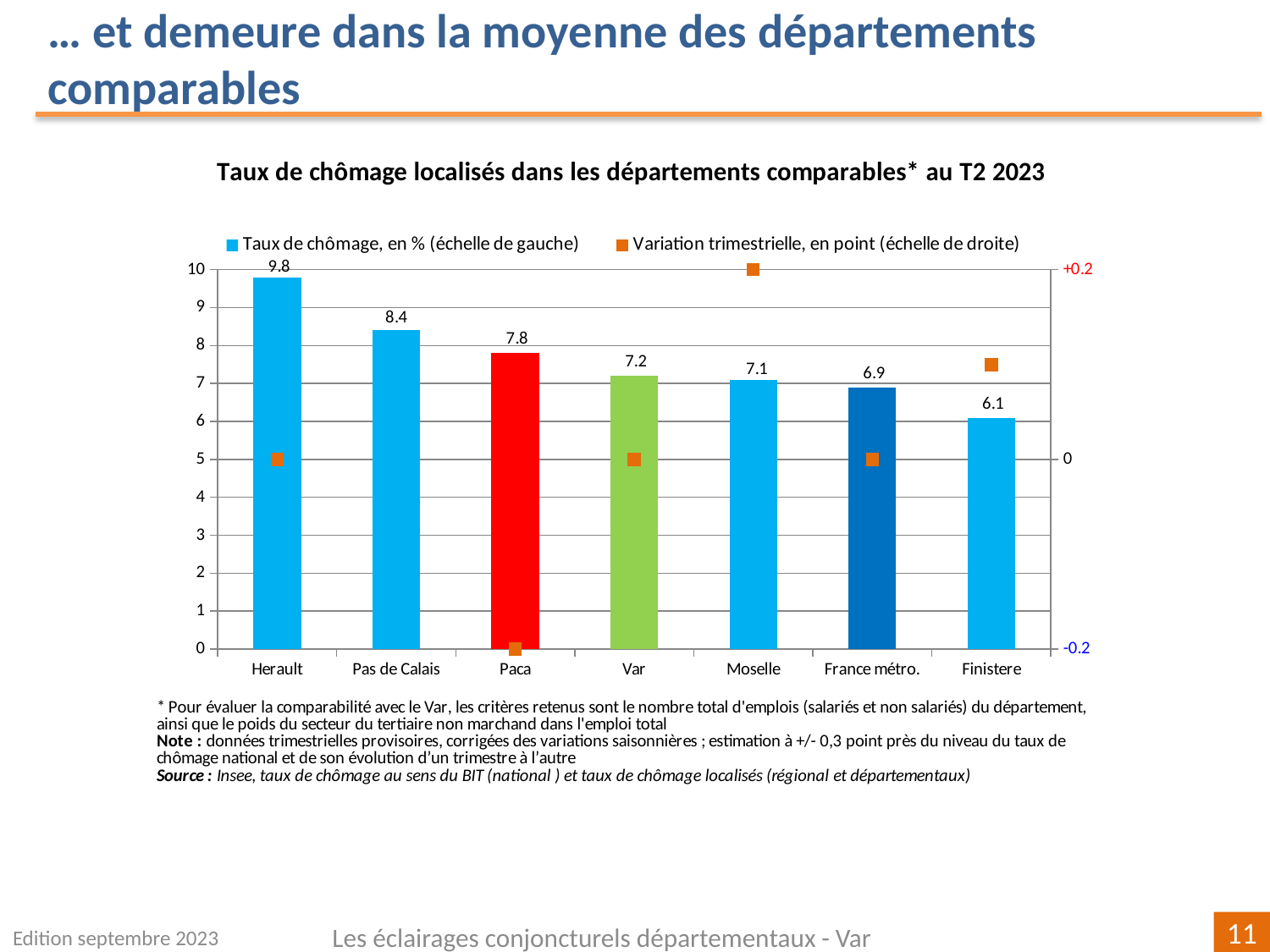
What is the unemployment rate shown for Finistere? 6.1 Which department has the highest unemployment rate on the chart? Herault What is the difference between the unemployment rates of Herault and Pas de Calais? 1.4 What kind of chart is used to show the unemployment rates? Bar chart What is the unemployment rate shown for Var? 7.2 Which category has the lowest unemployment rate on the chart? Finistere How many series does the legend list? 2 What is the quarterly variation (right-hand scale) shown for Moselle? +0.2 Which has a higher unemployment rate, Paca or Var? Paca Do the unemployment rate bars rise or fall from left to right along the x axis? Fall How many categories are shown on the x axis of the chart? 7 What is the unemployment rate shown for Herault? 9.8